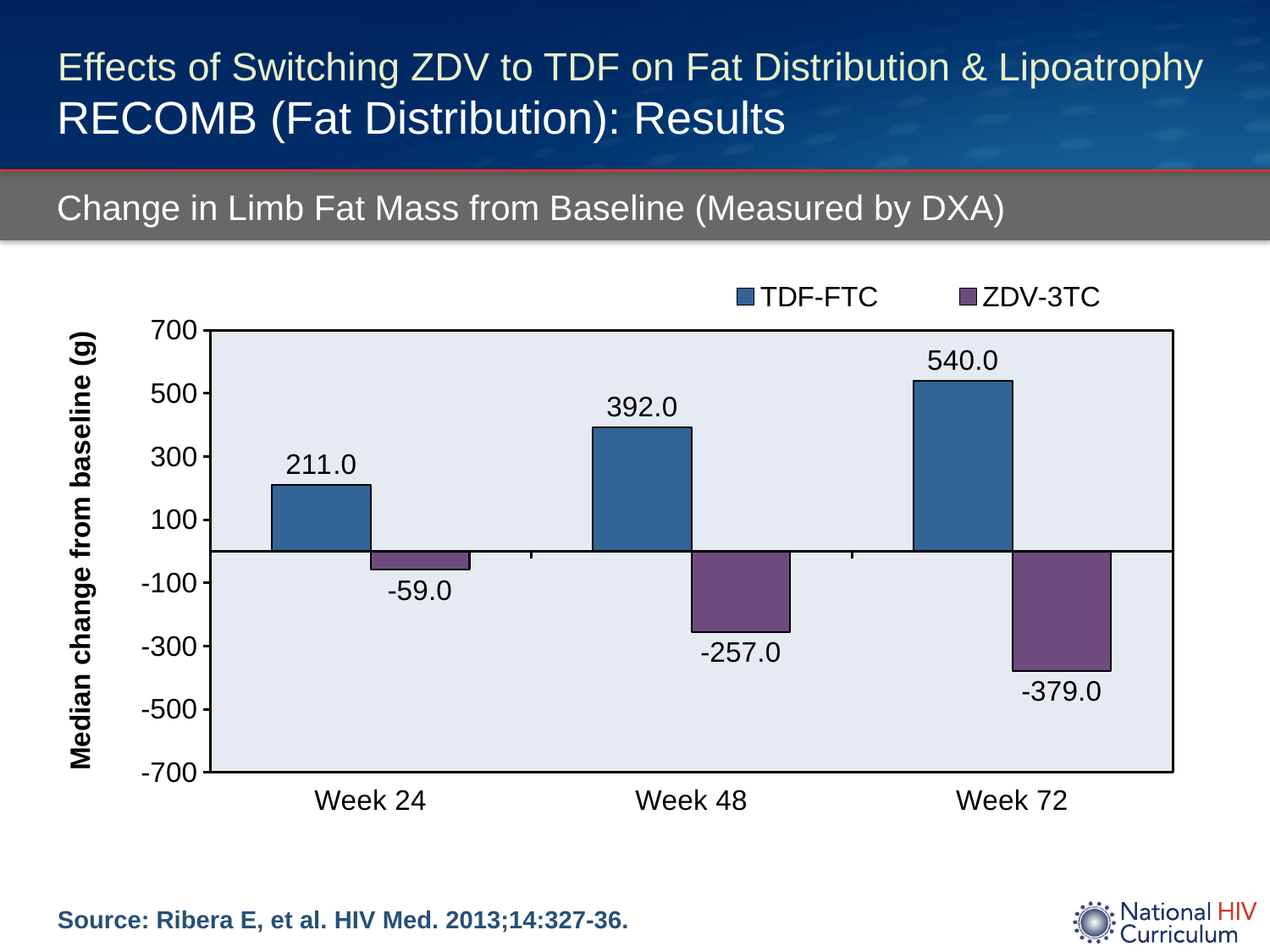
At which week is the ZDV-3TC value lowest? Week 72 Is the TDF-FTC value at Week 72 greater or less than 500? greater At which week is the TDF-FTC value highest? Week 72 What is the median change from baseline for ZDV-3TC at Week 72? -379.0 What kind of chart is shown on the slide? Bar chart How many series does the legend list? 2 What is the difference between the TDF-FTC values at Week 72 and Week 24? 329.0 What is the difference between the TDF-FTC and ZDV-3TC values at Week 48? 649.0 What is the median change from baseline for ZDV-3TC at Week 24? -59.0 What is the median change from baseline for TDF-FTC at Week 48? 392.0 Which series has the larger value at Week 24, TDF-FTC or ZDV-3TC? TDF-FTC How many week categories are shown on the x axis? 3